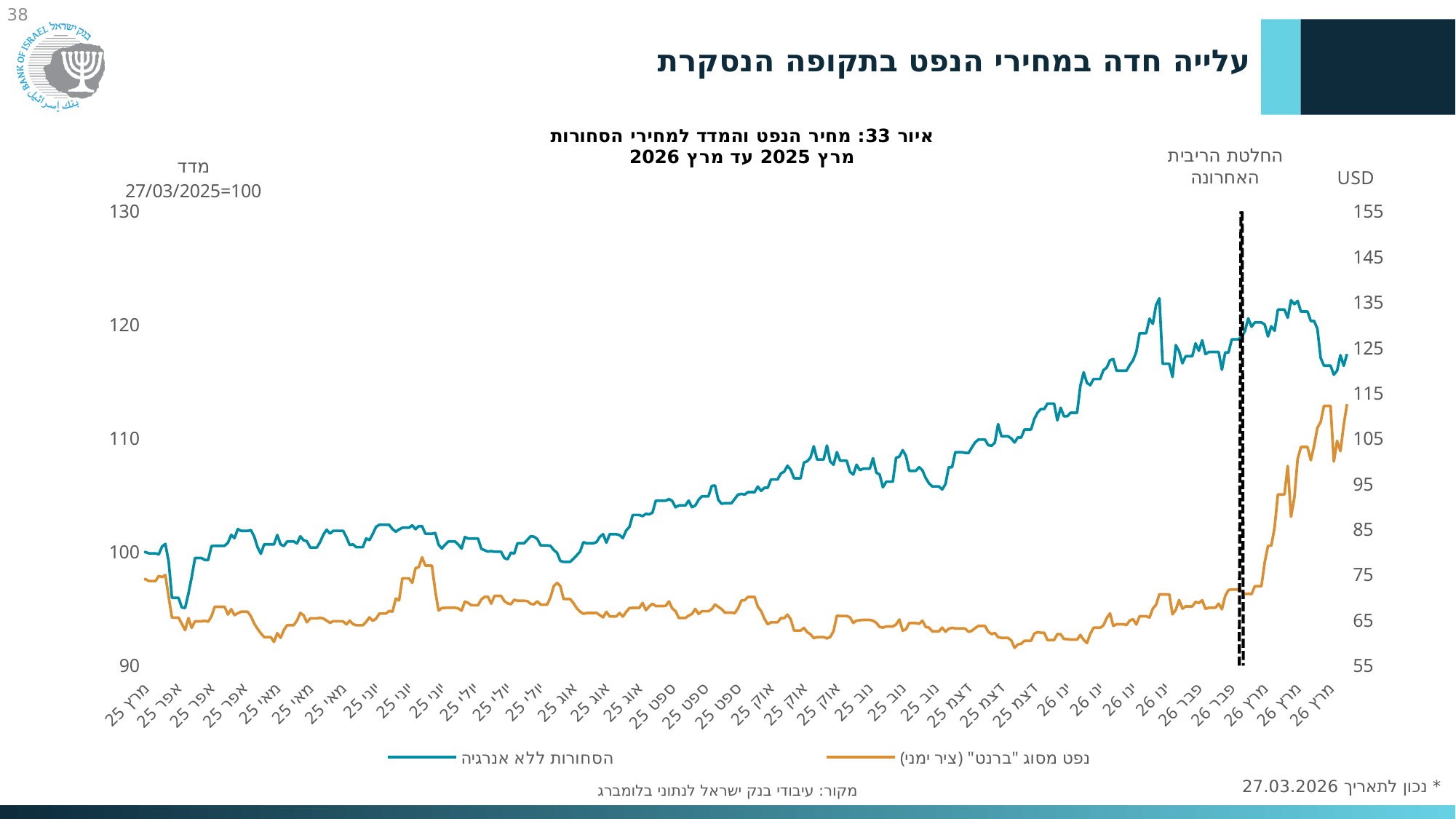
Is the Brent oil price at the start of the period (March 2025) greater or less than 85 USD? less What is the base date of the commodities index shown on the left axis? 27/03/2025=100 Is the non-energy commodities index in August 2025 greater or less than 110? less What kind of chart is shown on the slide? line chart Is the lowest Brent oil price in December 2025 greater or less than 65 USD? less Which series is plotted on the right axis (ציר ימני)? נפט מסוג "ברנט" How many series does the legend list? 2 Does the non-energy commodities index (blue line) rise or fall overall from March 2025 to March 2026? rise Does the Brent oil price (orange line) rise or fall during March 2026 at the right end of the chart? rise